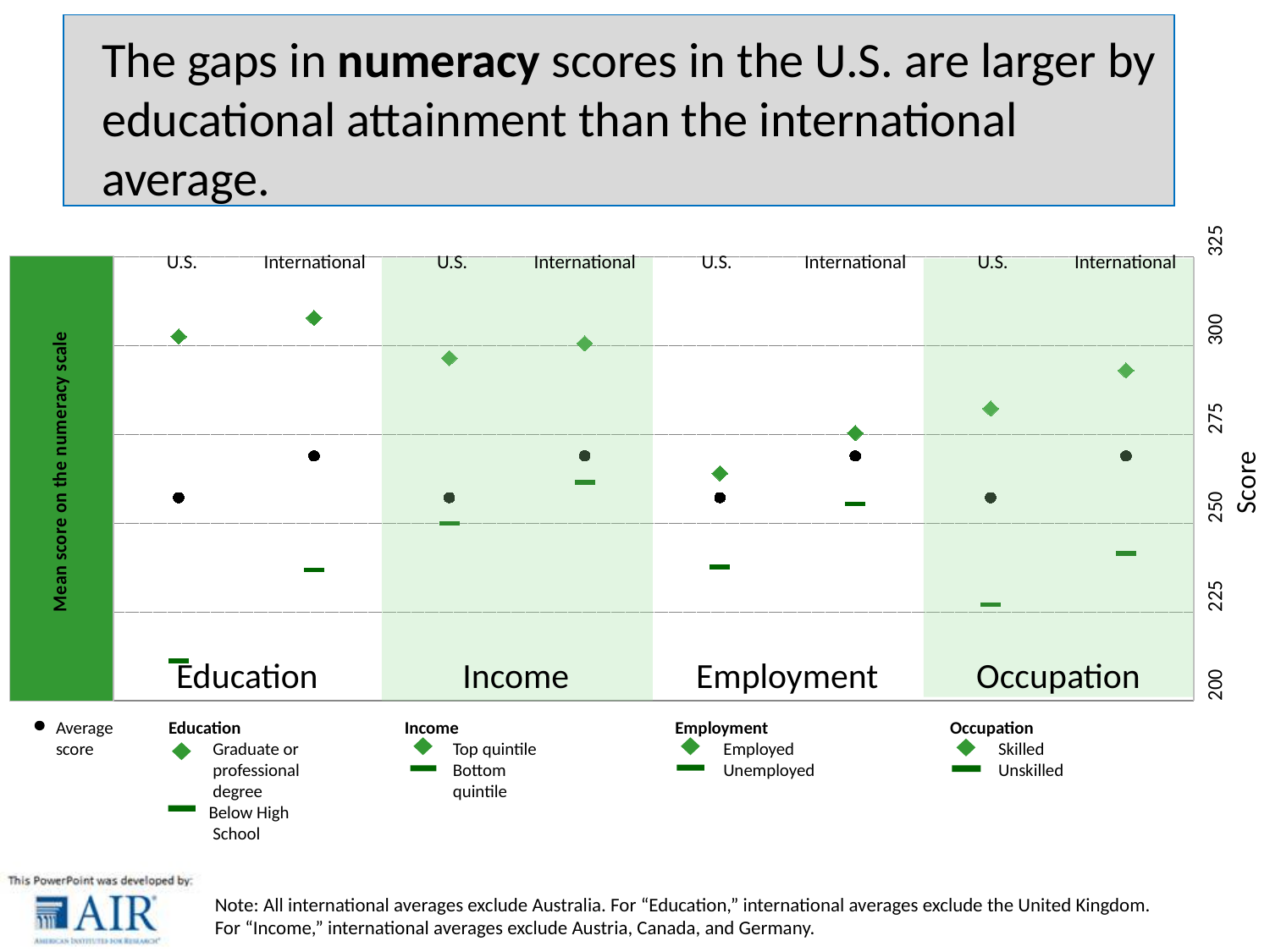
How many category panels (Education, Income, etc.) does the chart show? 4 In the Occupation panel, which is larger: the U.S. or the International value for Skilled? International In the Education panel, is the International value for Graduate or professional degree greater or less than 300? greater What is the label on the vertical axis of the chart? Mean score on the numeracy scale What type of chart is shown on the slide? Scatter (dot) chart In the Income panel, is the U.S. value for Top quintile greater or less than 275? greater In the Occupation panel, is the U.S. value for Unskilled greater or less than 250? less In the Education panel, which is larger: the U.S. or the International value for Below High School? International Which marker on the chart has the lowest score overall? U.S. Below High School (Education) In the Occupation legend, which two groups are listed? Skilled and Unskilled